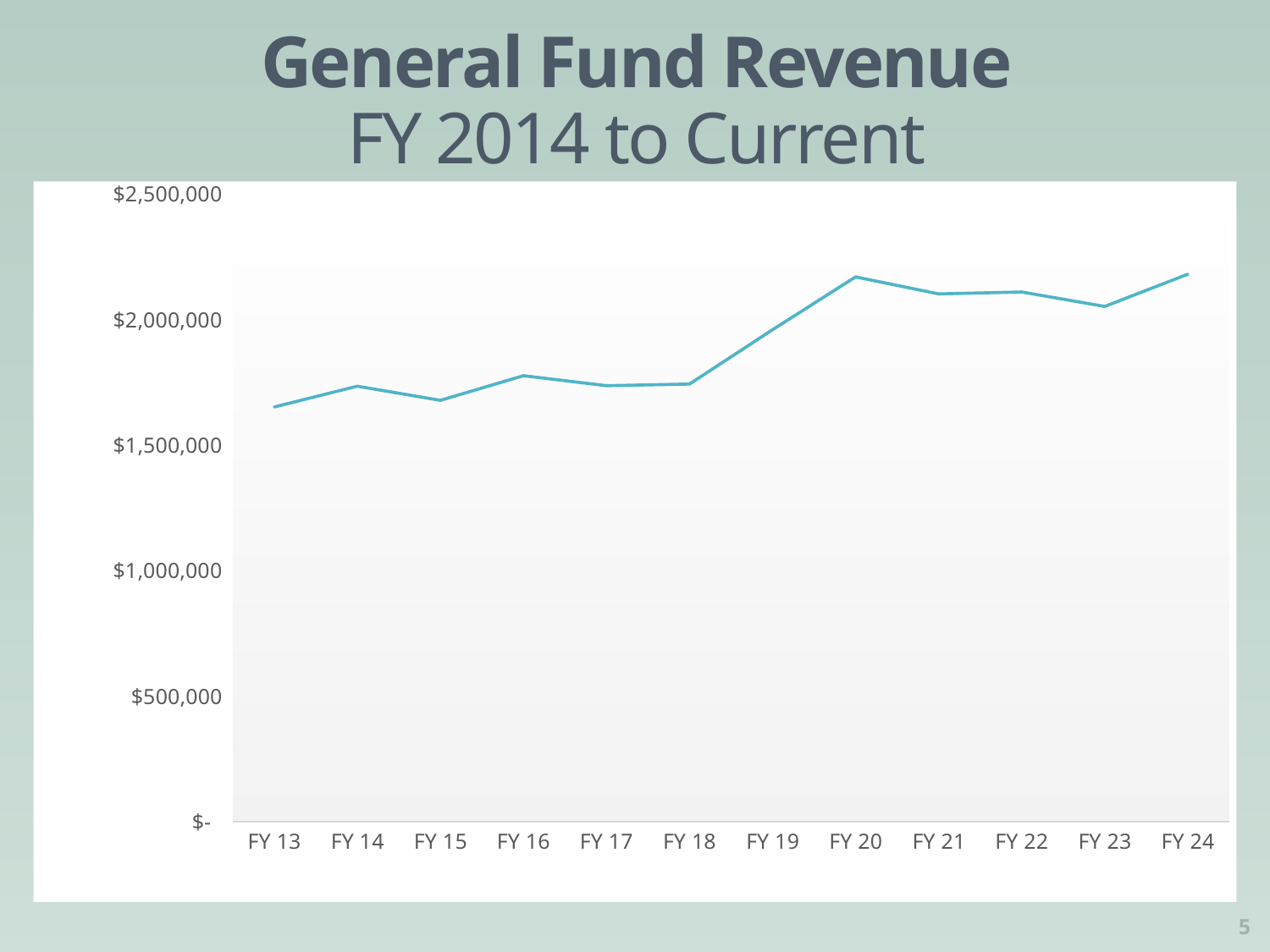
What is the highest value labelled on the y axis? $2,500,000 Is the value for FY 18 greater or less than $2,000,000? less Overall, do the values rise or fall from FY 13 to FY 24? rise Which is larger, the value for FY 18 or the value for FY 20? FY 20 What is the title of the slide containing the chart? General Fund Revenue FY 2014 to Current How many fiscal years are plotted on the x axis? 12 Which is larger, the value for FY 13 or the value for FY 24? FY 24 Is the value for FY 13 greater or less than $2,000,000? less What kind of chart is shown on the slide? line chart Is the value for FY 20 greater or less than $2,000,000? greater